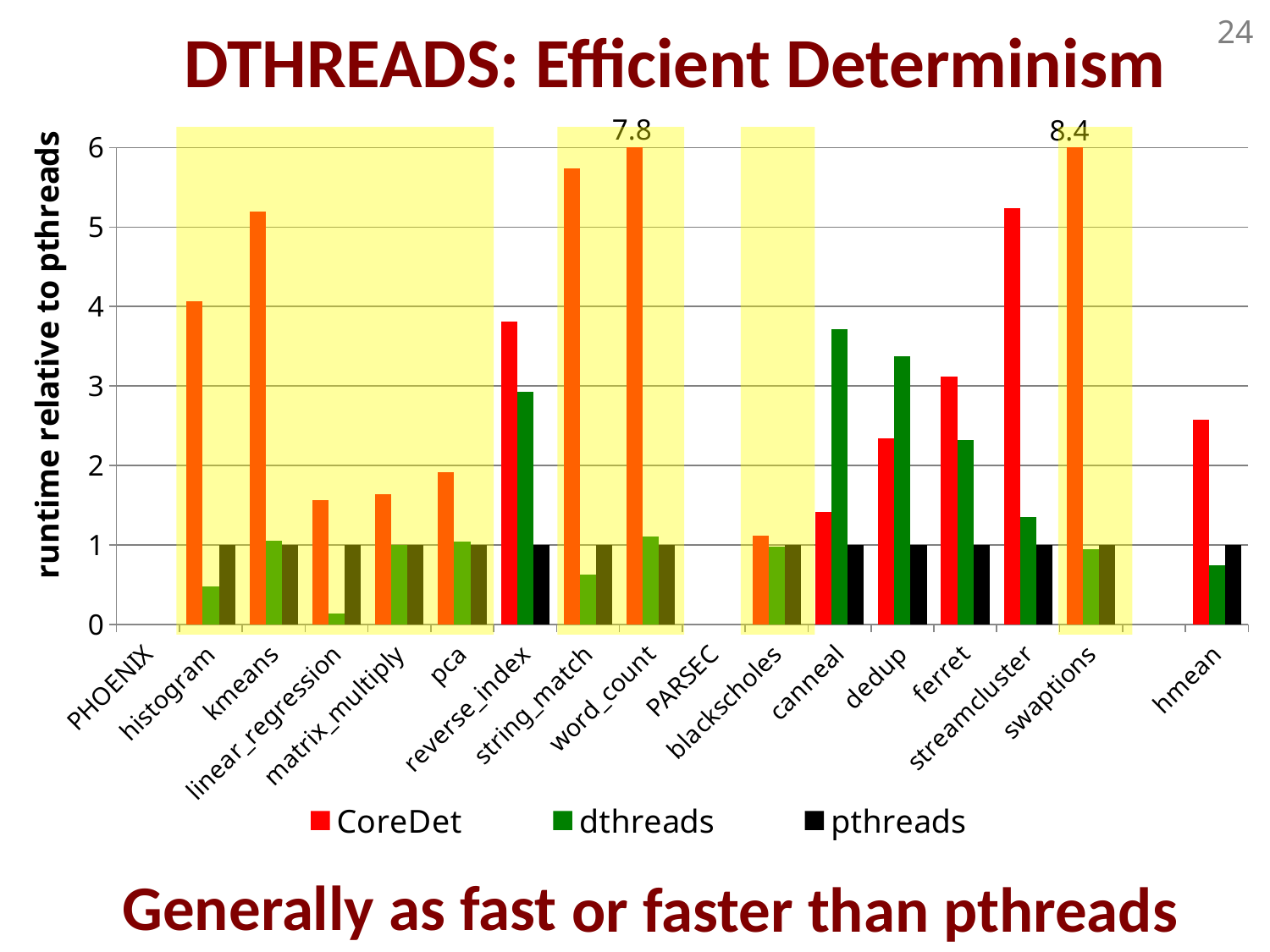
How many series does the legend list? 3 What is the CoreDet runtime relative to pthreads for swaptions? 8.4 Is the CoreDet value for histogram greater or less than 3? greater Is the dthreads value for canneal greater or less than 3? greater Which benchmark has the highest CoreDet value? swaptions What is the CoreDet runtime relative to pthreads for word_count? 7.8 What is the title of the y axis? runtime relative to pthreads Is the dthreads value for linear_regression greater or less than 1? less What kind of chart is shown on the slide? bar chart For canneal, which is larger: the CoreDet value or the dthreads value? dthreads What is the difference between the CoreDet values for swaptions and word_count? 0.6